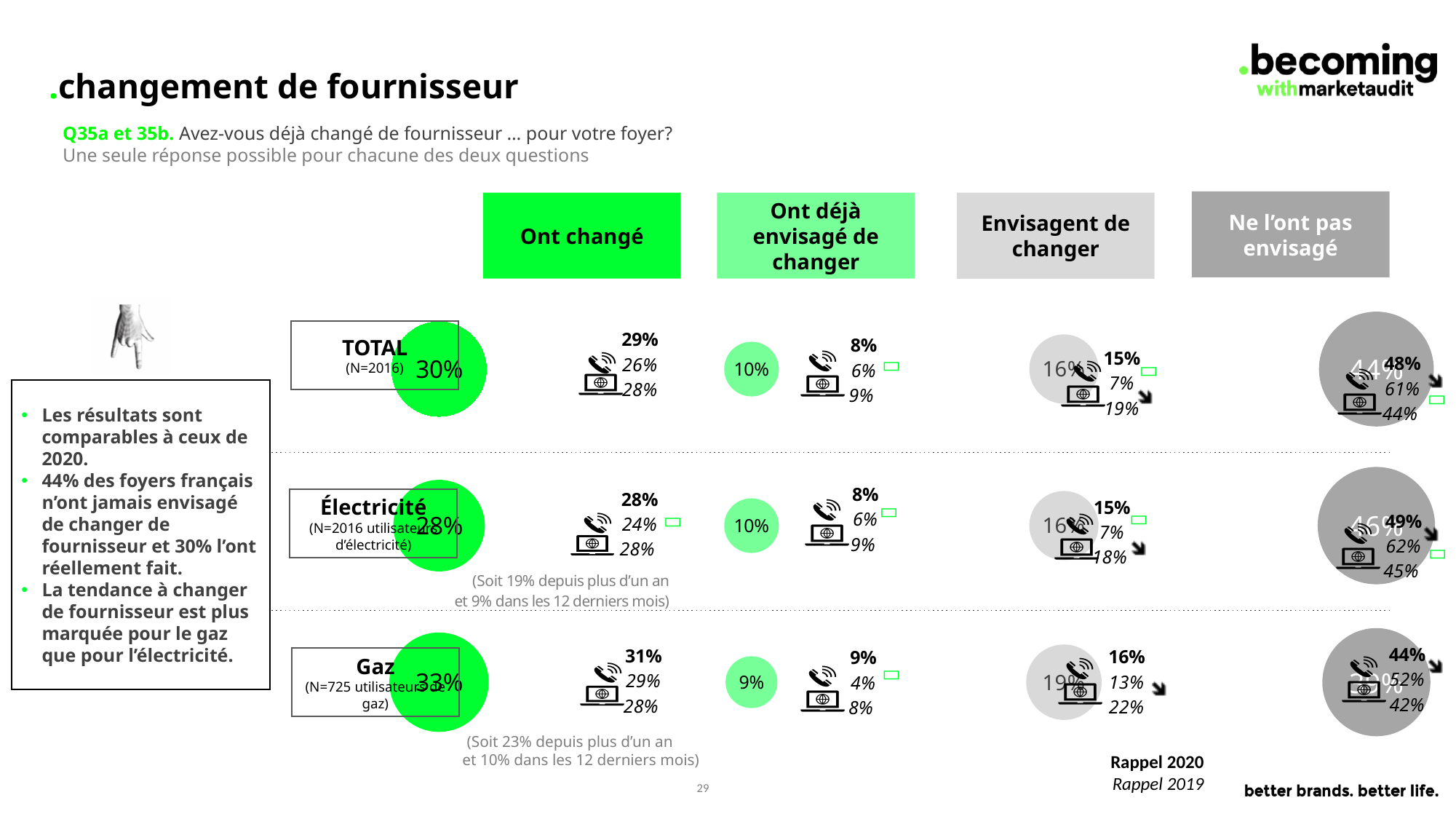
For Gaz, what percentage 'Ont déjà envisagé de changer'? 9% What percentage of the TOTAL sample 'Ne l'ont pas envisagé'? 44% Which row (TOTAL, Électricité or Gaz) has the highest share of 'Ont changé'? Gaz What percentage of the TOTAL sample 'Ont changé' (have changed supplier)? 30% For Gaz, what percentage 'Ont changé'? 33% Is the 'Ne l'ont pas envisagé' share larger for Électricité or for TOTAL? Électricité What is the difference between the 'Ont changé' share for Gaz and for Électricité? 5 percentage points Which row (TOTAL, Électricité or Gaz) has the lowest share of 'Ont changé'? Électricité How many response categories (columns) are shown across the top of the chart? 4 What is the sample size (N) for the Gaz row? 725 For Électricité, what percentage 'Envisagent de changer'? 16% What was the Rappel 2020 value for 'Ne l'ont pas envisagé' in the TOTAL row? 48%